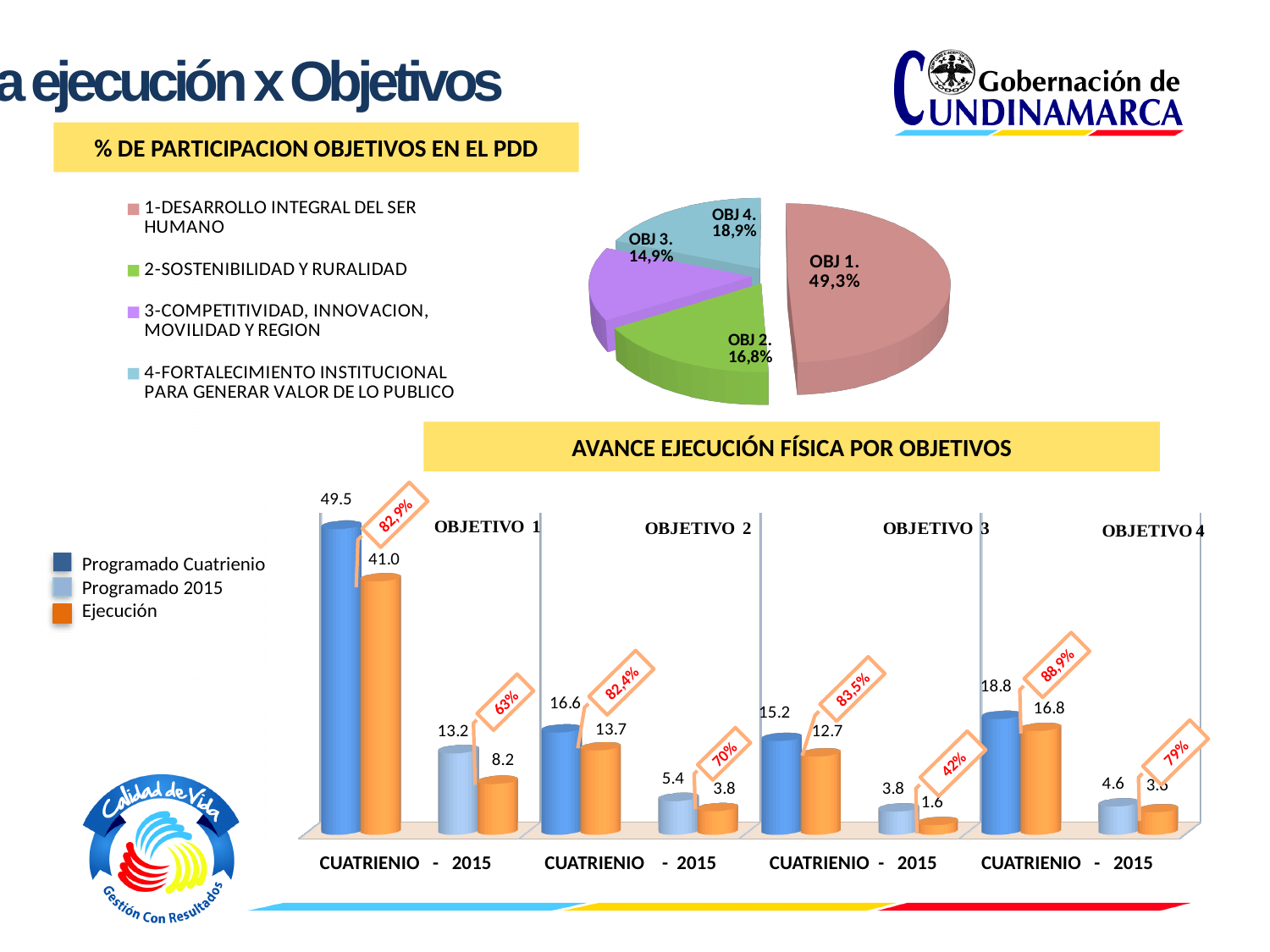
In the pie chart '% DE PARTICIPACION OBJETIVOS EN EL PDD', which is larger, OBJ 2 or OBJ 4? OBJ 4 In the bar chart 'AVANCE EJECUCIÓN FÍSICA POR OBJETIVOS', what is the Ejecución value for the Cuatrienio of OBJETIVO 4? 16.8 In the pie chart '% DE PARTICIPACION OBJETIVOS EN EL PDD', what is the value shown for OBJ 4? 18,9% In the bar chart 'AVANCE EJECUCIÓN FÍSICA POR OBJETIVOS', which objective has the highest Programado Cuatrienio value? OBJETIVO 1 In the bar chart 'AVANCE EJECUCIÓN FÍSICA POR OBJETIVOS', what is the difference between the Programado Cuatrienio and Ejecución values for OBJETIVO 2? 2.9 In the bar chart 'AVANCE EJECUCIÓN FÍSICA POR OBJETIVOS', what is the Programado 2015 value for OBJETIVO 3? 3.8 What kind of chart is the lower chart 'AVANCE EJECUCIÓN FÍSICA POR OBJETIVOS'? Bar chart In the pie chart '% DE PARTICIPACION OBJETIVOS EN EL PDD', what share does OBJ 1 have? 49,3% In the pie chart '% DE PARTICIPACION OBJETIVOS EN EL PDD', which objective has the smallest slice? OBJ 3 In the bar chart 'AVANCE EJECUCIÓN FÍSICA POR OBJETIVOS', how many series does the legend list? 3 In the bar chart 'AVANCE EJECUCIÓN FÍSICA POR OBJETIVOS', what is the Programado Cuatrienio value for OBJETIVO 1? 49.5 In the pie chart '% DE PARTICIPACION OBJETIVOS EN EL PDD', how many slices are there? 4